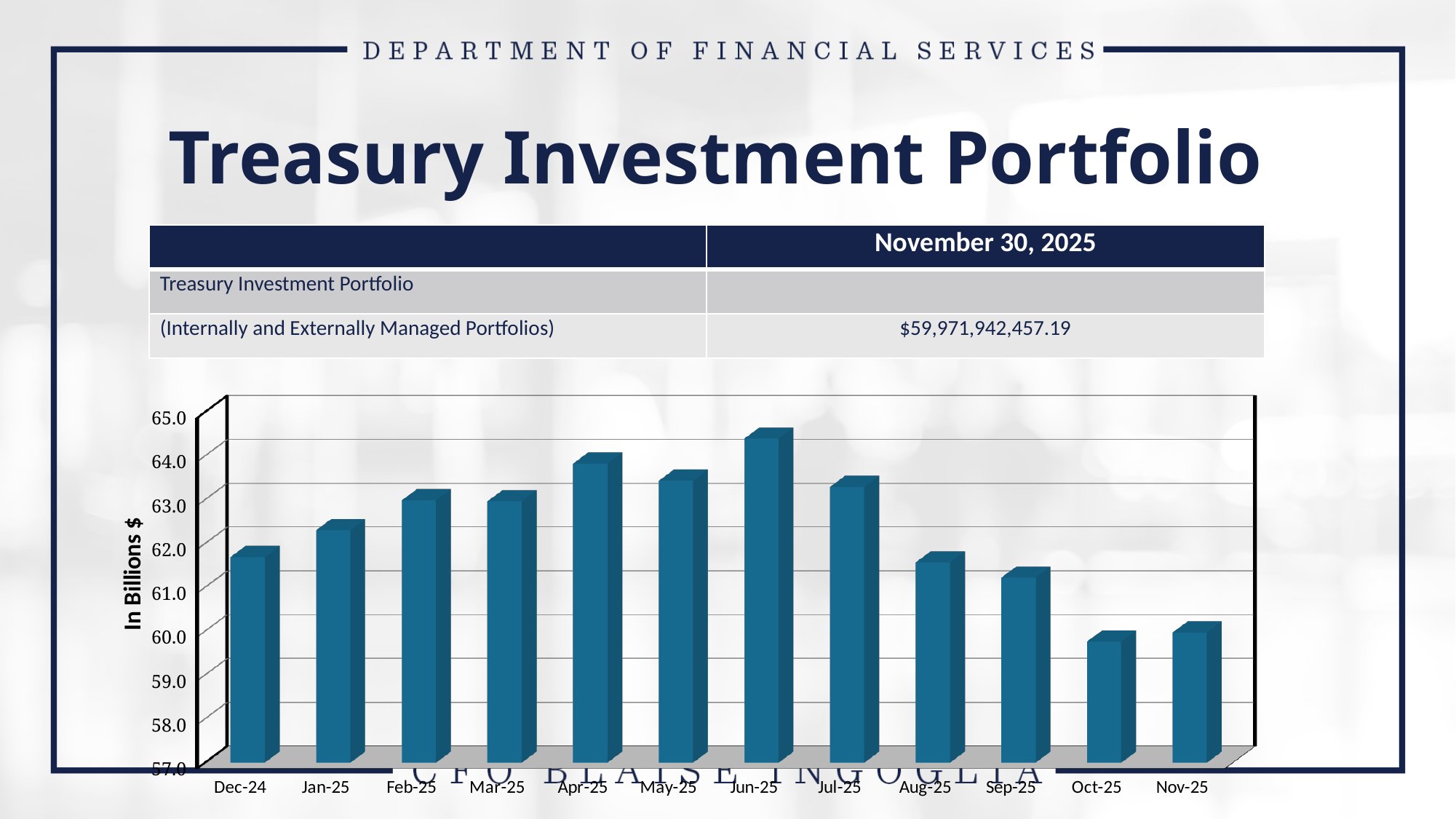
Is the value for Aug-25 greater or less than 62.0? less Do the values rise or fall from Jul-25 to Oct-25? fall Is the value for Apr-25 greater or less than 63.0? greater Which is larger, the value for Jan-25 or the value for Aug-25? Jan-25 What is the label on the vertical axis of the chart? In Billions $ Is the value for Jun-25 greater or less than 64.0? greater Which month has the highest value in the chart? Jun-25 How many months are plotted on the x axis of the chart? 12 Which is larger, the value for Apr-25 or the value for May-25? Apr-25 What kind of chart is shown on the slide? bar chart